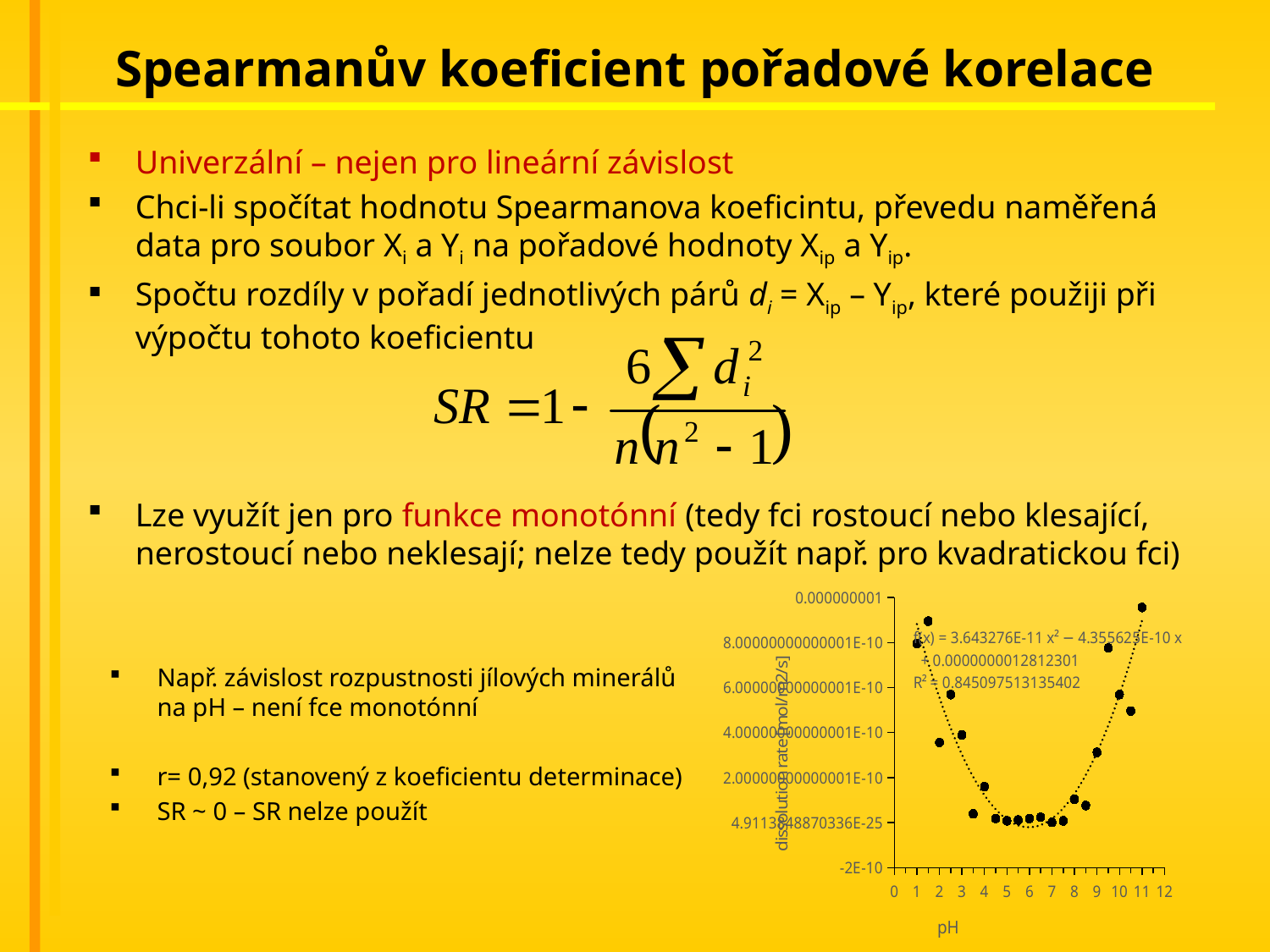
What is the highest tick label shown on the y axis of the chart? 0.000000001 Which has the larger dissolution rate, the point at pH 2 or the point at pH 10? pH 10 Do the dissolution rate values rise or fall as pH increases from 8 to 11? rise What kind of chart is shown at the bottom right of the slide? scatter chart What is the highest tick label shown on the x axis of the chart? 12 At which pH value does the chart show its highest dissolution rate point? 11 Do the dissolution rate values rise or fall as pH increases from 1 to 5? fall What R² value is printed on the chart? R² = 0.845097513135402 What is the lowest tick label shown on the y axis of the chart? -2E-10 Is the dissolution rate at pH 11 greater or less than 8.00000000000001E-10? greater Is the dissolution rate at pH 5 greater or less than 2.00000000000001E-10? less What is the label of the x axis of the chart? pH